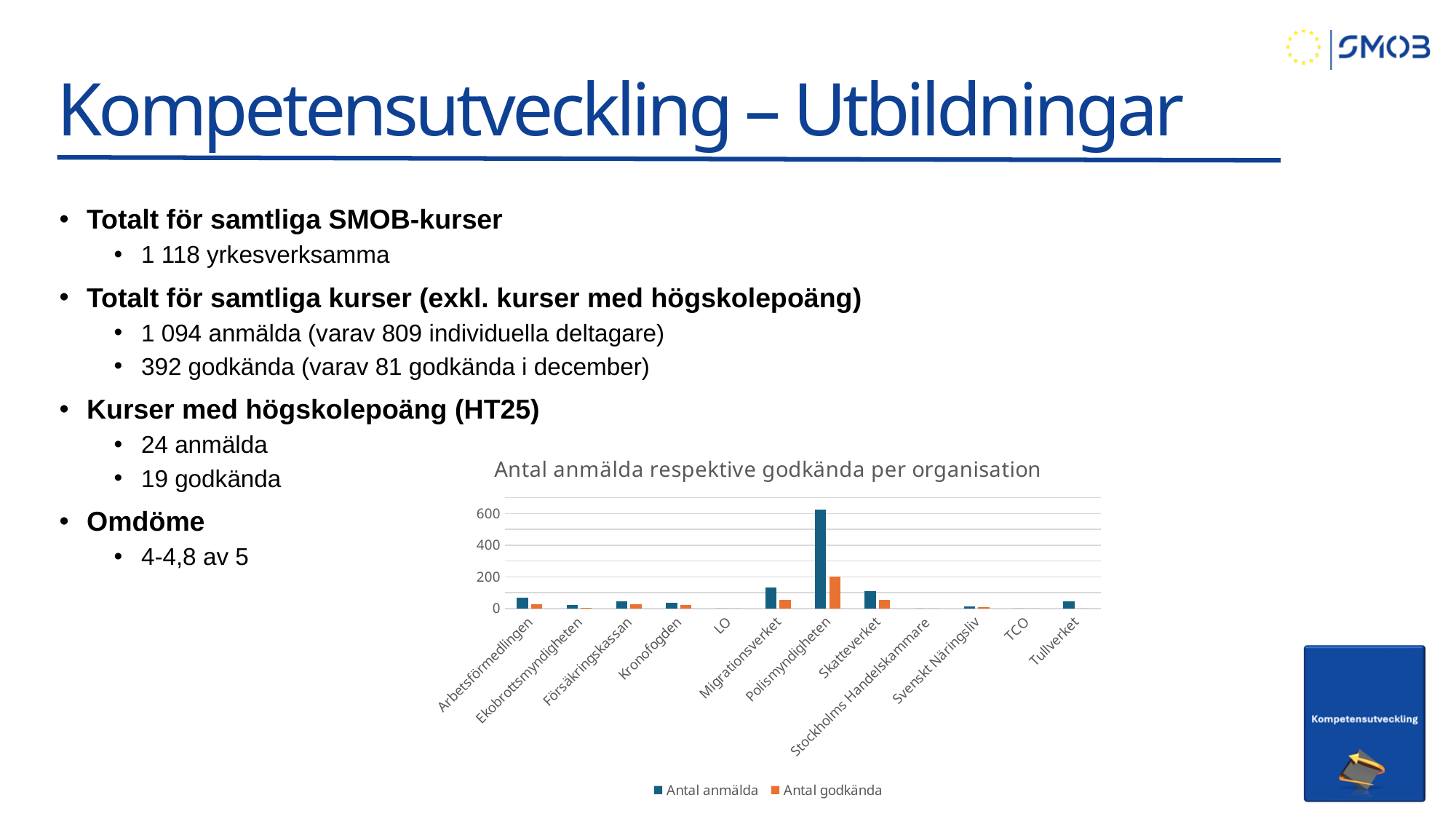
How many series does the chart's legend list? 2 Is the Antal anmälda value for Migrationsverket greater or less than 200? less Which has the larger Antal anmälda value, Arbetsförmedlingen or Ekobrottsmyndigheten? Arbetsförmedlingen Which organisation has the highest value for Antal godkända? Polismyndigheten Which has the larger Antal anmälda value, Polismyndigheten or Migrationsverket? Polismyndigheten Which series is shown in orange in the chart? Antal godkända Is the Antal anmälda value for Skatteverket greater or less than 200? less What is the title of the chart on the slide? Antal anmälda respektive godkända per organisation Which organisation has the highest value for Antal anmälda? Polismyndigheten How many organisations are shown on the x axis of the chart? 12 What kind of chart is shown on the slide? Bar chart Is the Antal anmälda value for Polismyndigheten greater or less than 400? greater